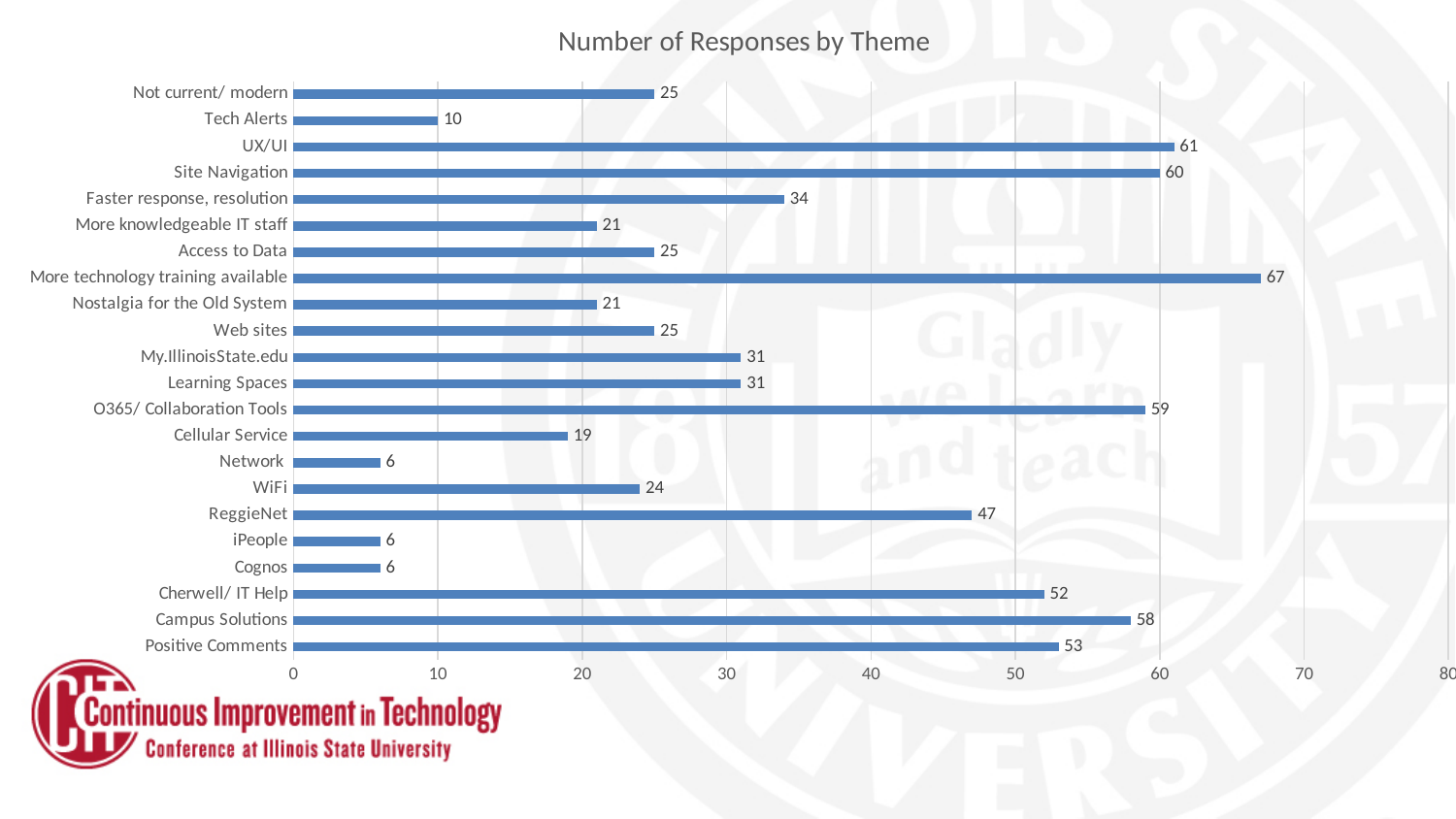
How many themes are plotted on the chart? 22 Which theme has the highest number of responses? More technology training available How many responses are shown for ReggieNet? 47 Is the value for My.IllinoisState.edu greater or less than 40? less Which has more responses, O365/ Collaboration Tools or Positive Comments? O365/ Collaboration Tools Which has more responses, Faster response, resolution or WiFi? Faster response, resolution What is the difference between the values for Campus Solutions and Cherwell/ IT Help? 6 What value is shown for Cellular Service? 19 What type of chart is shown on the slide? Bar chart What is the title of the chart? Number of Responses by Theme What is the number of responses for UX/UI? 61 What is the difference in responses between Site Navigation and Tech Alerts? 50